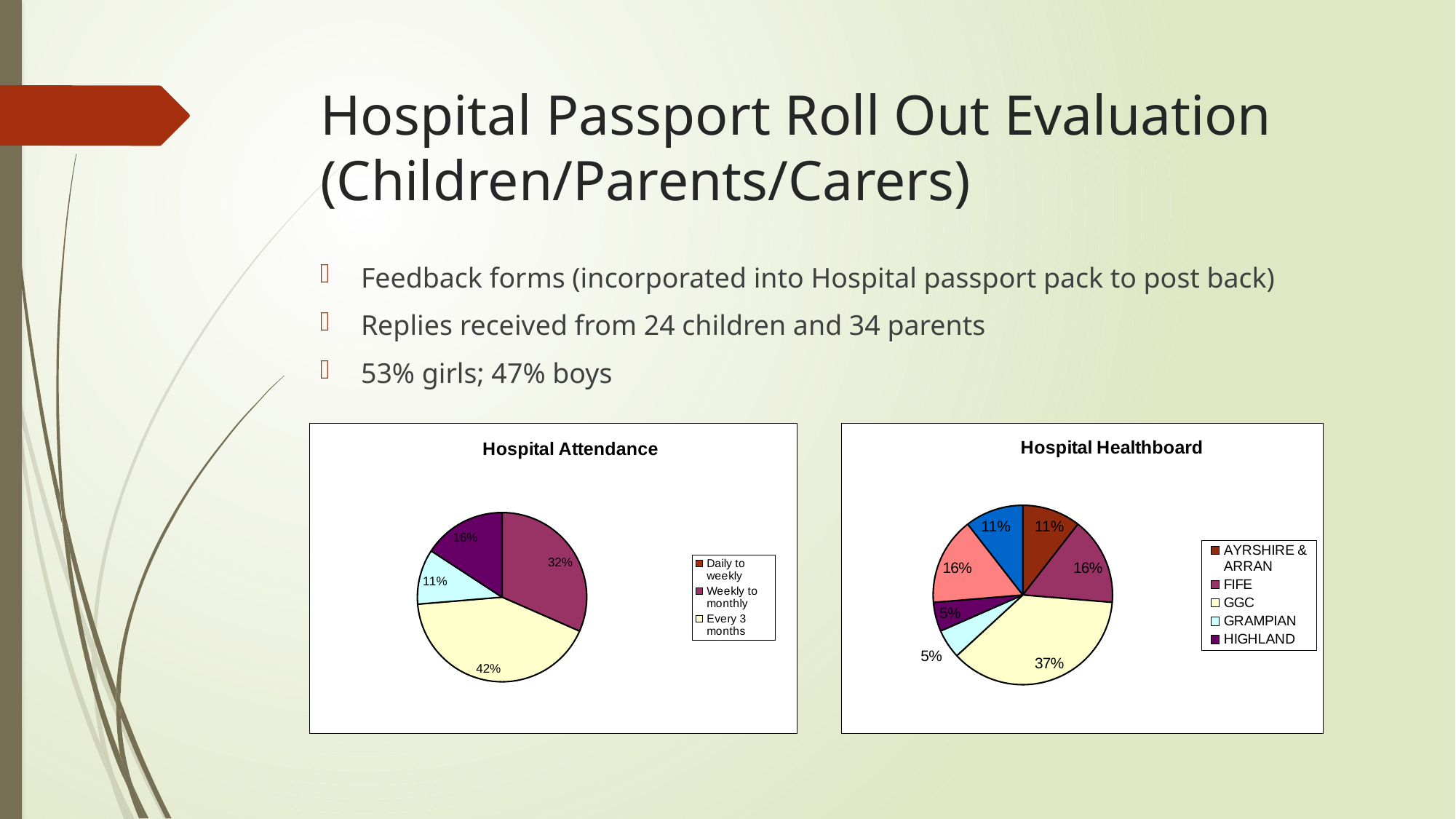
In the Hospital Attendance chart, what percentage is shown for Every 3 months? 42% In the Hospital Attendance chart, how many percentage points larger is the Every 3 months slice than the Weekly to monthly slice? 10 percentage points In the Hospital Healthboard chart, what percentage is shown for GGC? 37% In the Hospital Healthboard chart, what percentage is shown for GRAMPIAN? 5% In the Hospital Attendance chart, which legend category has the largest slice? Every 3 months In the Hospital Healthboard chart, what percentage is shown for AYRSHIRE & ARRAN? 11% In the Hospital Healthboard chart, which health board has the largest slice? GGC In the Hospital Healthboard chart, which slice is larger, FIFE or AYRSHIRE & ARRAN? FIFE How many entries does the legend of the Hospital Healthboard chart list? 5 In the Hospital Attendance chart, what percentage is shown for Weekly to monthly? 32% How many entries does the legend of the Hospital Attendance chart list? 3 What kind of chart is the Hospital Attendance chart? Pie chart